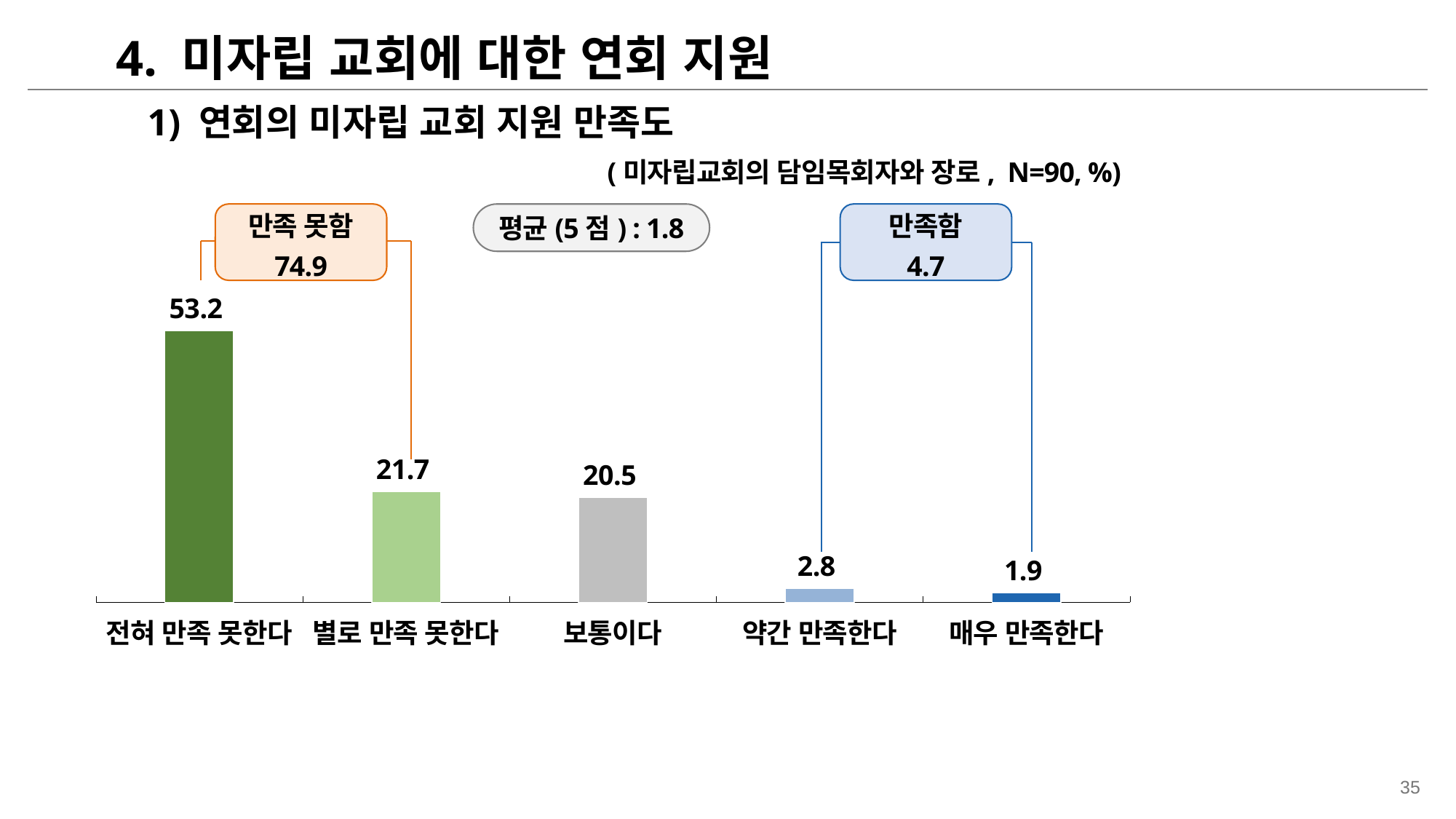
What is the value for 전혀 만족 못한다? 53.2 What is the difference between the values for 전혀 만족 못한다 and 별로 만족 못한다? 31.5 How many categories are shown on the x axis? 5 What is the value for 별로 만족 못한다? 21.7 What is the value for 보통이다? 20.5 What kind of chart is shown on the slide? bar chart What is the value for 매우 만족한다? 1.9 Which category has the highest value? 전혀 만족 못한다 Which is larger, the value for 약간 만족한다 or 매우 만족한다? 약간 만족한다 Which category has the lowest value? 매우 만족한다 What is the average (평균) score out of 5 shown on the slide? 1.8 What is the combined value shown for 만족 못함? 74.9